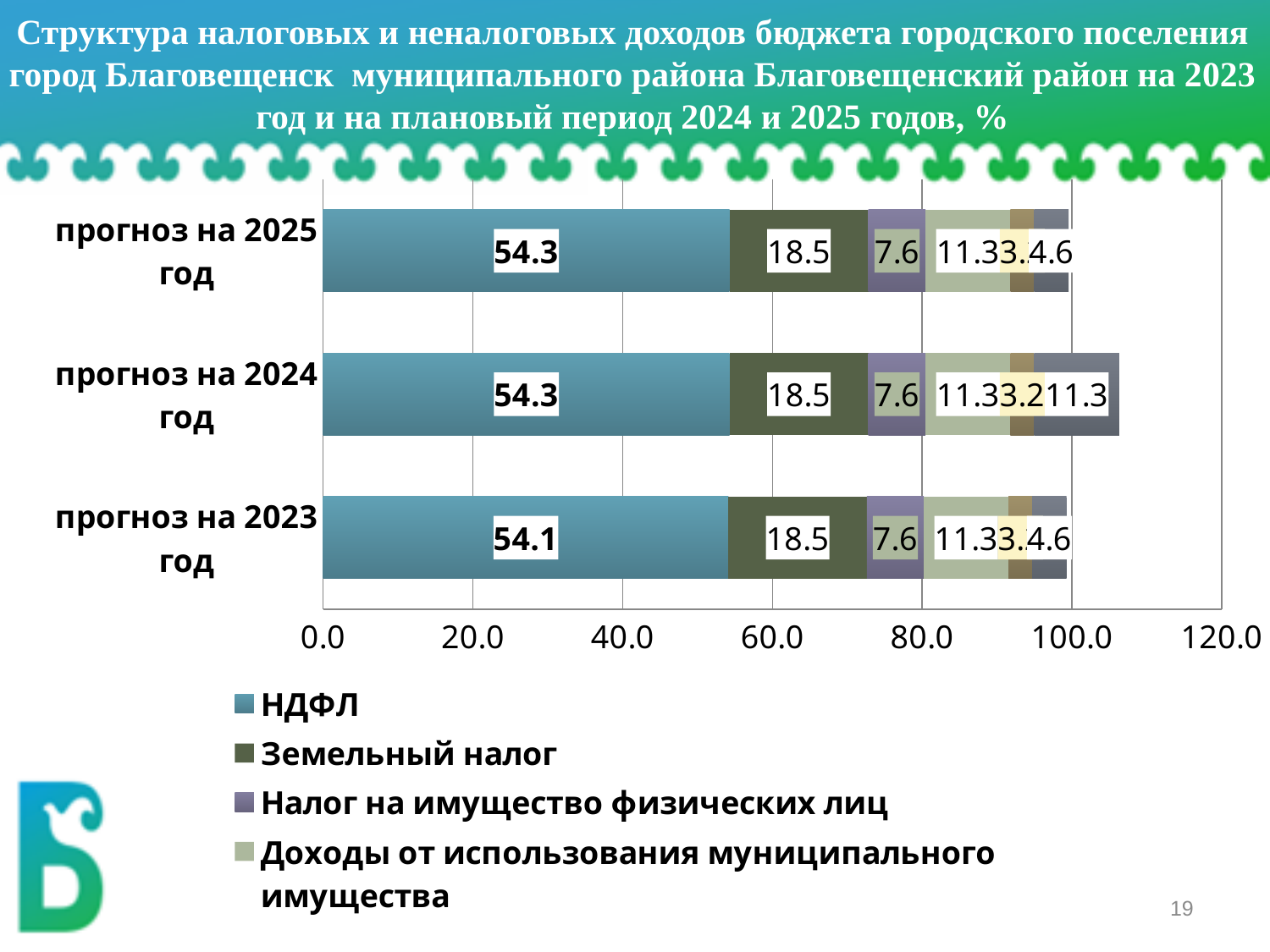
What is the value of НДФЛ for прогноз на 2023 год? 54.1 How many series does the legend list? 4 Is the total length of the bar for прогноз на 2024 год greater or less than 100.0? greater What kind of chart is shown on the slide? bar chart For прогноз на 2024 год, which is larger: НДФЛ or Земельный налог? НДФЛ What is the value of НДФЛ for прогноз на 2025 год? 54.3 What is the difference between the НДФЛ value for прогноз на 2025 год and for прогноз на 2023 год? 0.2 What is the value of Доходы от использования муниципального имущества for прогноз на 2025 год? 11.3 How many categories (forecast years) are shown on the chart? 3 For which forecast year is the НДФЛ value the lowest? прогноз на 2023 год What is the value of Земельный налог for прогноз на 2024 год? 18.5 What is the value of Налог на имущество физических лиц for прогноз на 2023 год? 7.6